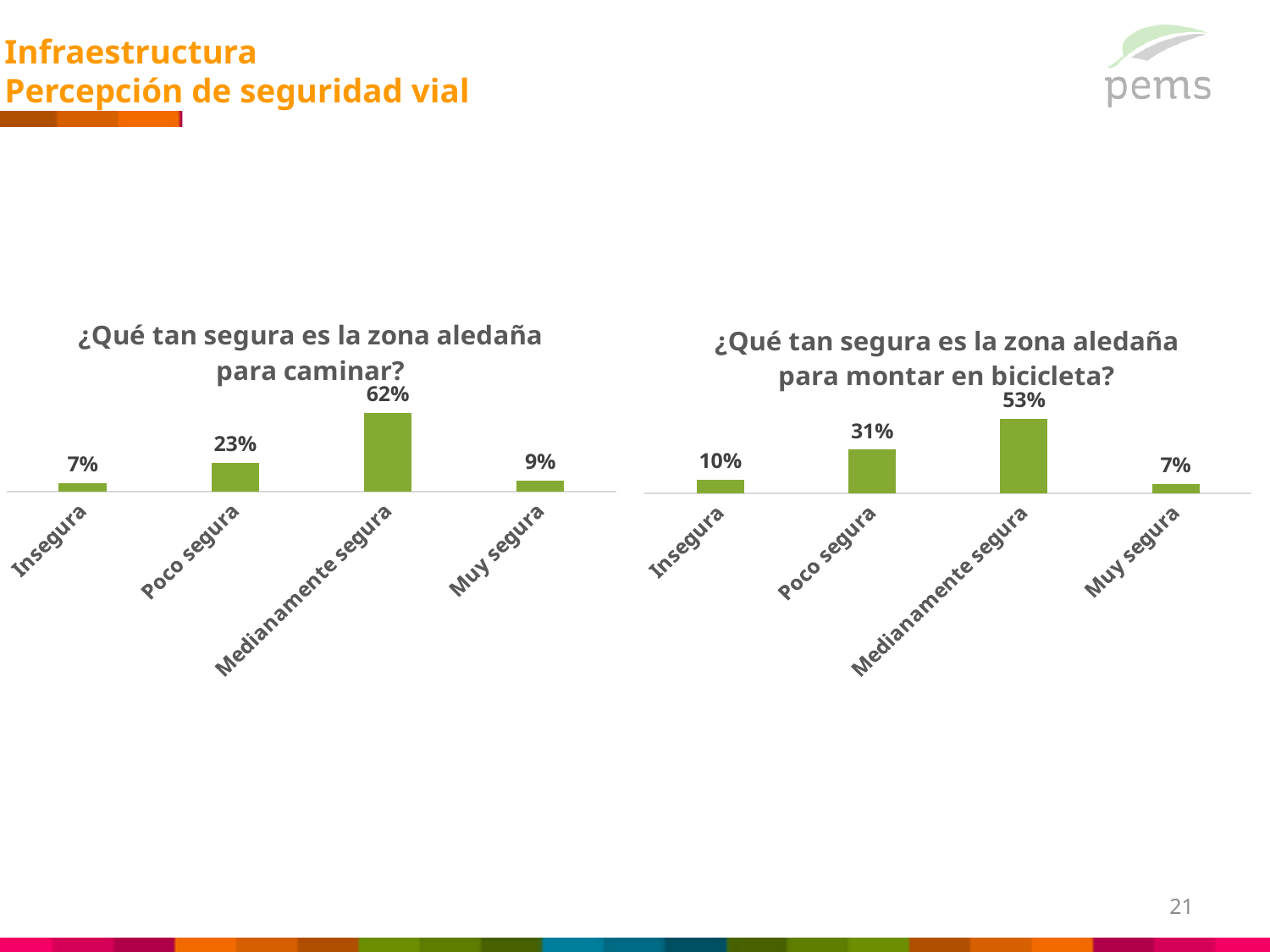
What type of chart is the left chart '¿Qué tan segura es la zona aledaña para caminar?'? bar chart In the left chart '¿Qué tan segura es la zona aledaña para caminar?', which category has the lowest value? Insegura Which is larger: 'Insegura' in the left chart (para caminar) or 'Insegura' in the right chart (para montar en bicicleta)? Insegura in the right chart (para montar en bicicleta) In the left chart '¿Qué tan segura es la zona aledaña para caminar?', what is the value for 'Medianamente segura'? 62% In the right chart '¿Qué tan segura es la zona aledaña para montar en bicicleta?', which category has the lowest value? Muy segura In the left chart '¿Qué tan segura es la zona aledaña para caminar?', what is the difference between 'Medianamente segura' and 'Poco segura'? 39% How many categories are shown in the right chart '¿Qué tan segura es la zona aledaña para montar en bicicleta?'? 4 In the left chart '¿Qué tan segura es la zona aledaña para caminar?', is 'Muy segura' larger or smaller than 'Poco segura'? smaller What is the title of the right chart? ¿Qué tan segura es la zona aledaña para montar en bicicleta? In the right chart '¿Qué tan segura es la zona aledaña para montar en bicicleta?', what is the difference between 'Medianamente segura' and 'Insegura'? 43% In the right chart '¿Qué tan segura es la zona aledaña para montar en bicicleta?', which category has the highest value? Medianamente segura In the right chart '¿Qué tan segura es la zona aledaña para montar en bicicleta?', what is the value for 'Poco segura'? 31%